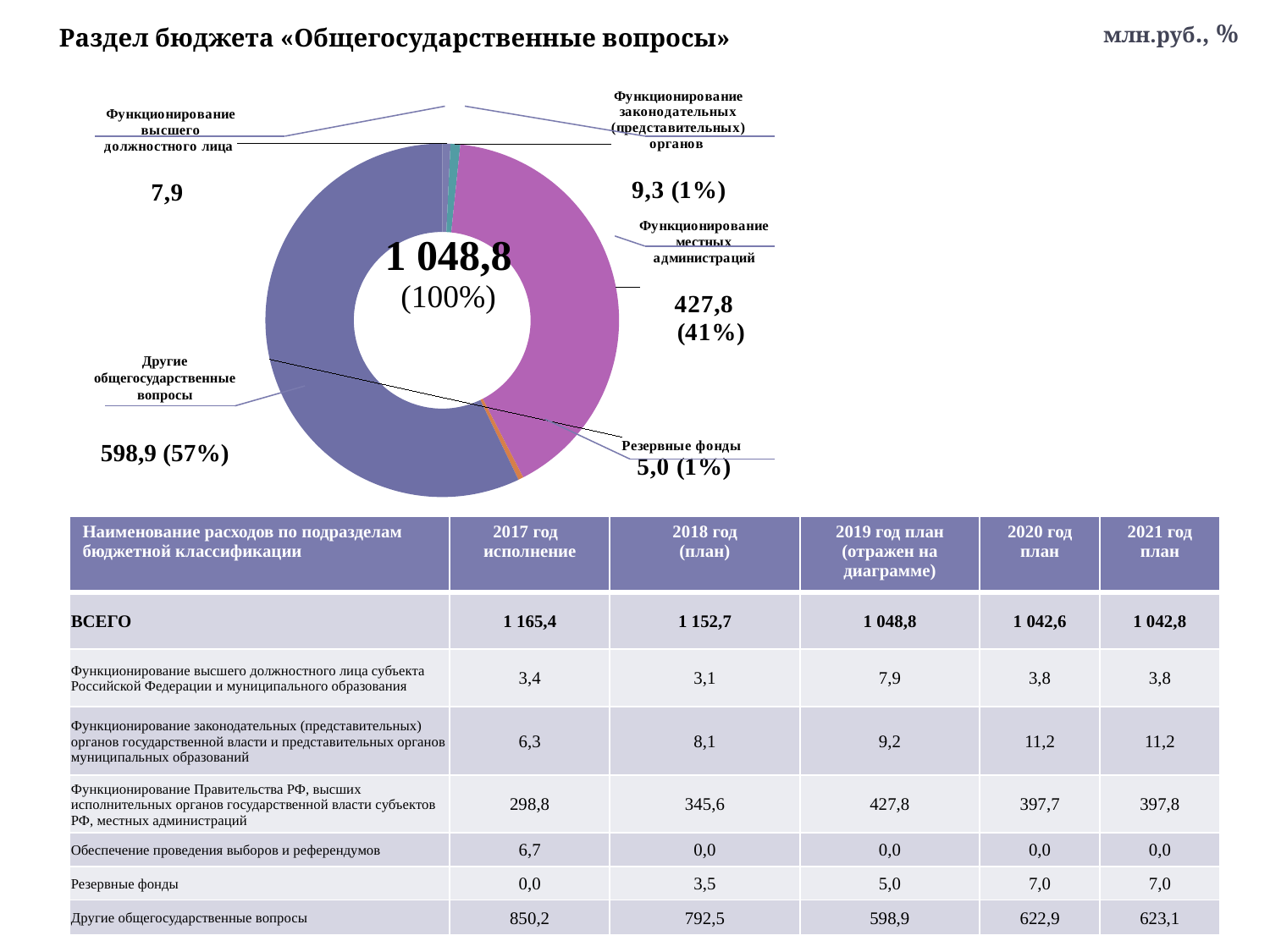
How many labelled categories are shown on the donut chart? 5 Which category has the largest slice in the chart? Другие общегосударственные вопросы What share of the chart does «Другие общегосударственные вопросы» account for? 57% What share of the chart does «Функционирование местных администраций» account for? 41% What kind of chart is shown on the slide? Donut (pie) chart Which category has the smallest slice in the chart? Резервные фонды What value is shown for «Резервные фонды» on the chart? 5,0 Which is larger on the chart: «Функционирование законодательных (представительных) органов» or «Функционирование высшего должностного лица»? Функционирование законодательных (представительных) органов What is the difference between the values for «Другие общегосударственные вопросы» and «Функционирование местных администраций» on the chart? 171,1 What value is shown for «Функционирование местных администраций» on the chart? 427,8 What value is shown for «Функционирование высшего должностного лица» on the chart? 7,9 What is the total value shown in the centre of the donut chart? 1 048,8